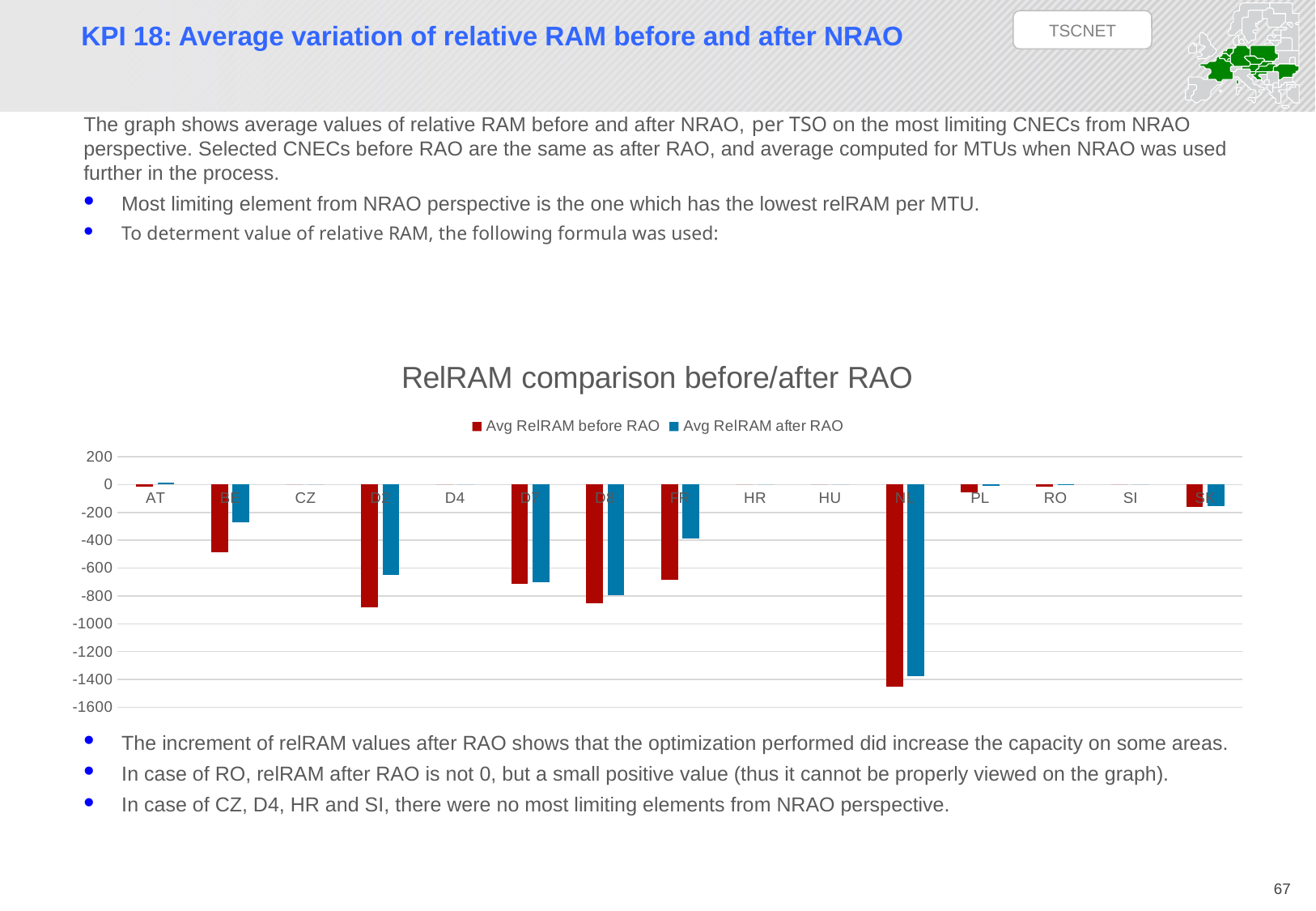
Which category has the lowest value for 'Avg RelRAM after RAO'? NL How many categories are shown on the x axis of the 'RelRAM comparison before/after RAO' chart? 15 How many series does the legend of the 'RelRAM comparison before/after RAO' chart list? 2 What colour are the 'Avg RelRAM after RAO' bars in the chart? blue Is the value of 'Avg RelRAM before RAO' for FR greater or less than -600? less Is the value of 'Avg RelRAM before RAO' for D2 greater or less than -800? less Is the value of 'Avg RelRAM after RAO' for BE greater or less than -400? greater For BE, which is larger: 'Avg RelRAM before RAO' or 'Avg RelRAM after RAO'? Avg RelRAM after RAO What kind of chart is 'RelRAM comparison before/after RAO'? bar chart Which category has the lowest value for 'Avg RelRAM before RAO'? NL Which is larger: 'Avg RelRAM before RAO' for BE or for D2? BE